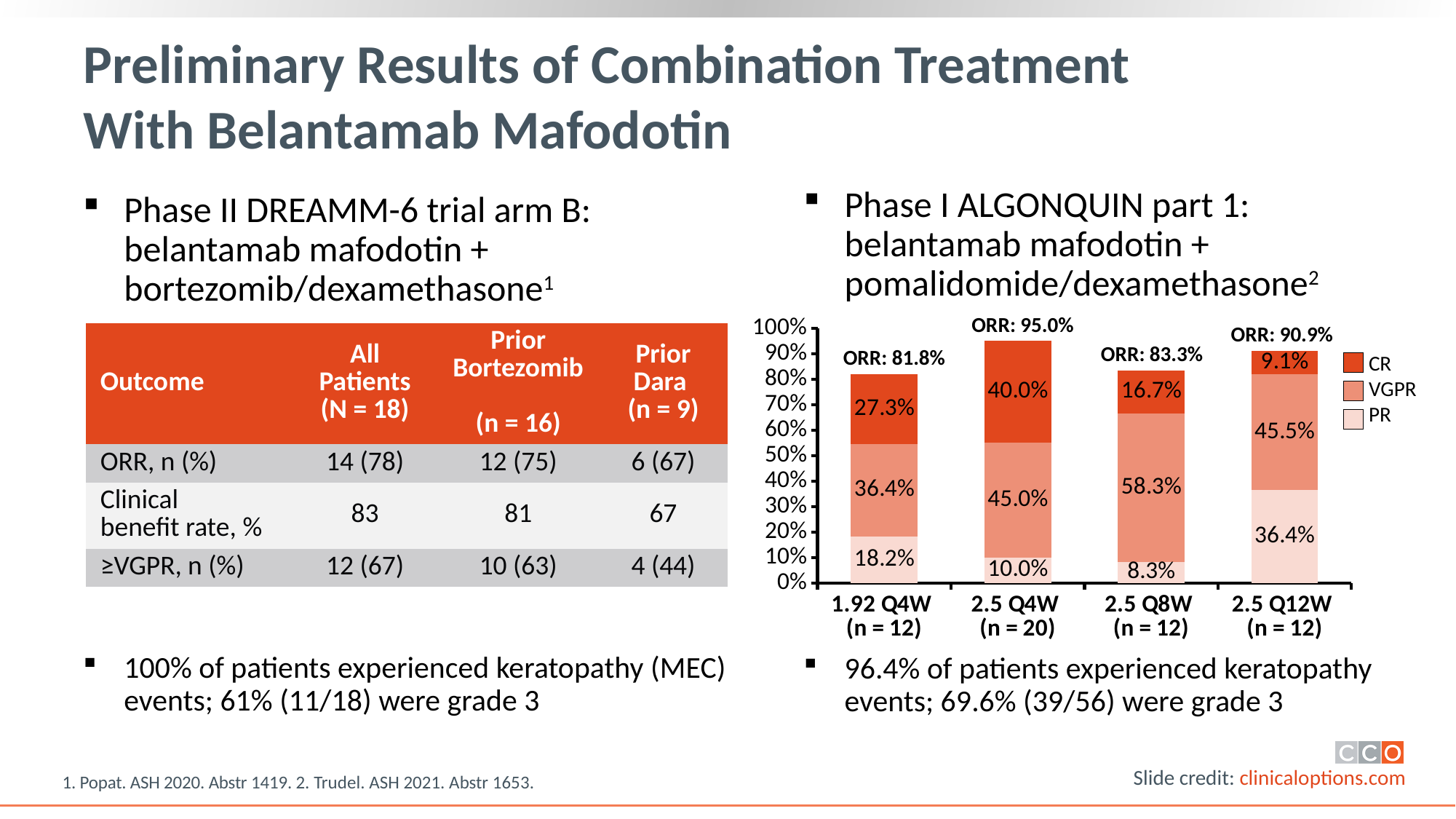
Which cohort has the highest ORR? 2.5 Q4W What is the VGPR value for the 2.5 Q8W cohort? 58.3% What ORR is labeled above the 1.92 Q4W bar? ORR: 81.8% How many dosing cohorts (bars) are shown in the chart? 4 Which cohort has the lowest CR value? 2.5 Q12W What is the PR value for the 2.5 Q12W cohort? 36.4% What is the CR value for the 2.5 Q4W cohort? 40.0% How many series does the chart legend list? 3 What type of chart is shown on the slide? Stacked bar chart What is the difference between the VGPR values of the 2.5 Q8W and 1.92 Q4W cohorts? 21.9% What is the total of the stacked bar for the 2.5 Q4W cohort? 95.0% Which is larger, the PR value for 1.92 Q4W or the PR value for 2.5 Q4W? 1.92 Q4W